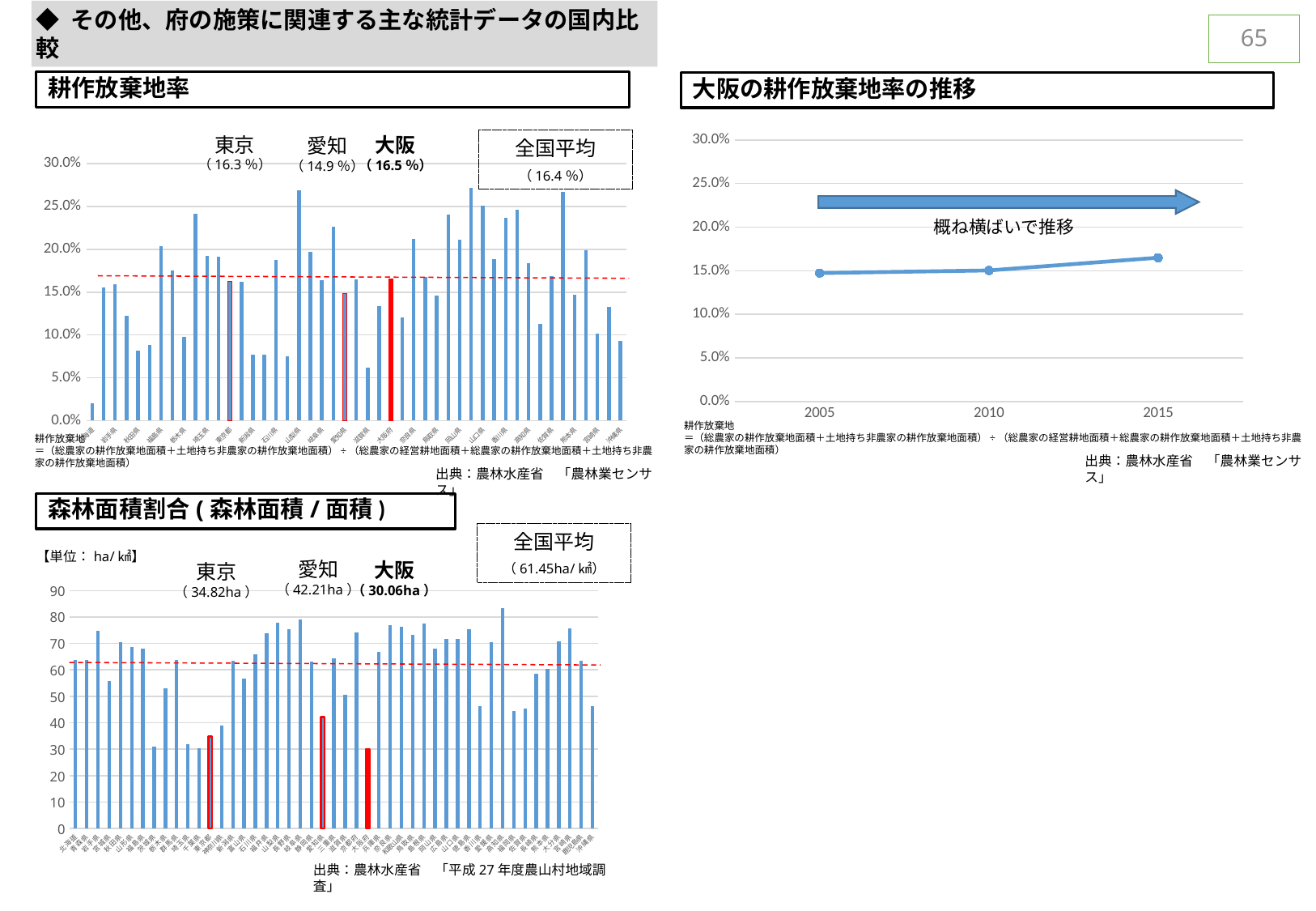
In the 大阪の耕作放棄地率の推移 chart, is the value for 2005 greater or less than 20.0%? less How many data points are plotted in the 大阪の耕作放棄地率の推移 chart? 3 In the 耕作放棄地率 chart, what is the difference between the values for 大阪 and 愛知? 1.6% What kind of chart is the 大阪の耕作放棄地率の推移 chart on the right? line chart In the 森林面積割合 chart, what is the 全国平均 value? 61.45ha/㎢ In the 森林面積割合 chart, which is larger, the value for 東京 or the value for 愛知? 愛知 What kind of chart is the 耕作放棄地率 chart on the left? bar chart In the 耕作放棄地率 chart, which is larger, the value for 大阪 or the value for 愛知? 大阪 In the 耕作放棄地率 chart, what is the 全国平均 value? 16.4% In the 森林面積割合 chart, what is the value for 大阪? 30.06ha In the 耕作放棄地率 chart, what is the value for 大阪? 16.5% In the 耕作放棄地率 chart, what is the value for 東京? 16.3%